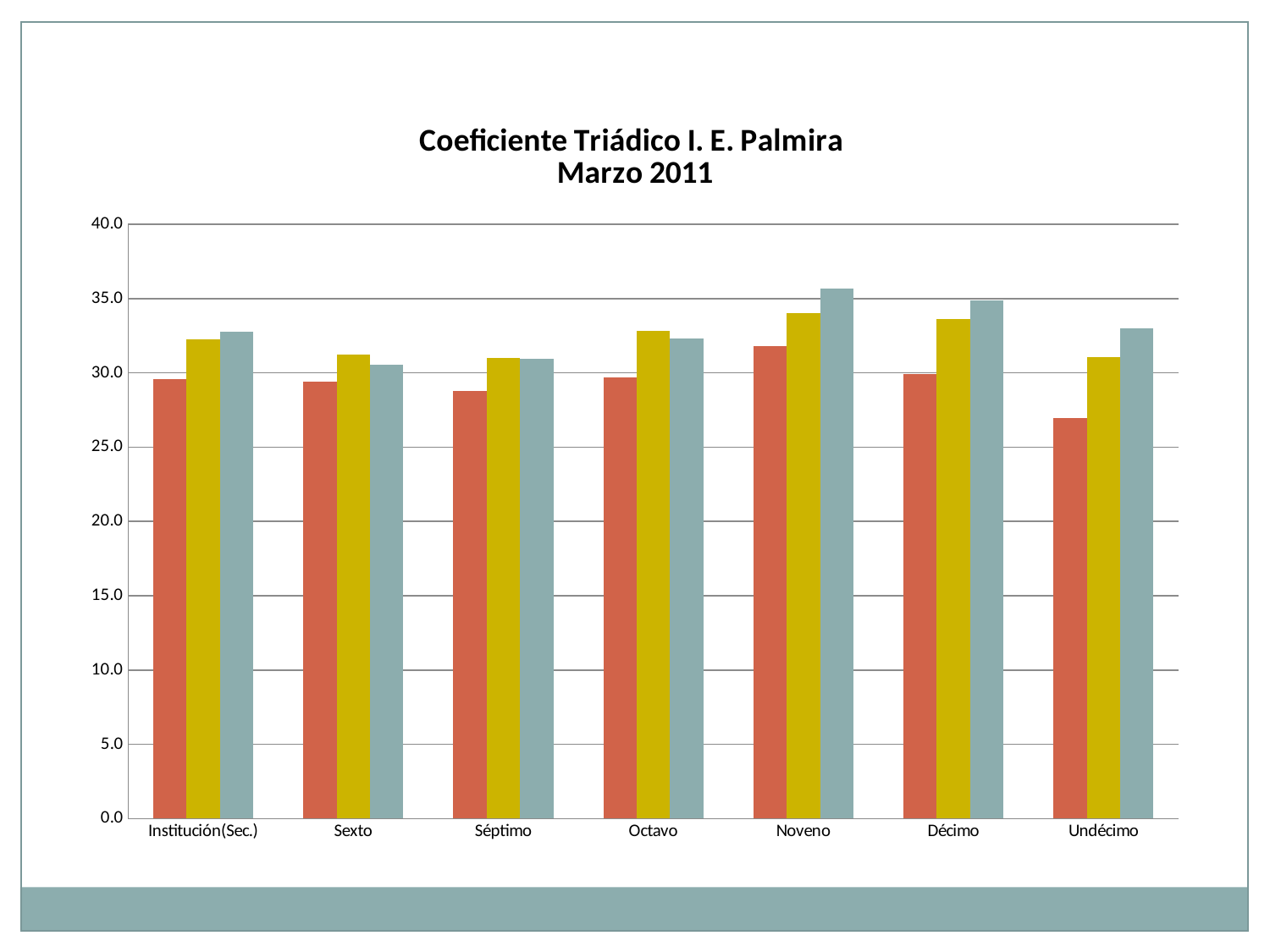
Which category has the tallest red bar? Noveno Is the red bar for Noveno greater or less than 30.0? greater What is the title of the chart? Coeficiente Triádico I. E. Palmira Marzo 2011 How many categories are shown on the x axis? 7 What kind of chart is shown on the slide? bar chart In the Noveno category, which coloured bar is the tallest? blue-grey Which category has the shortest red bar? Undécimo Which is larger, the red bar for Noveno or the red bar for Undécimo? Noveno Is the red bar for Undécimo greater or less than 30.0? less Which category has the tallest blue-grey bar? Noveno Is the blue-grey bar for Noveno greater or less than 35.0? greater How many bars are plotted for each category? 3